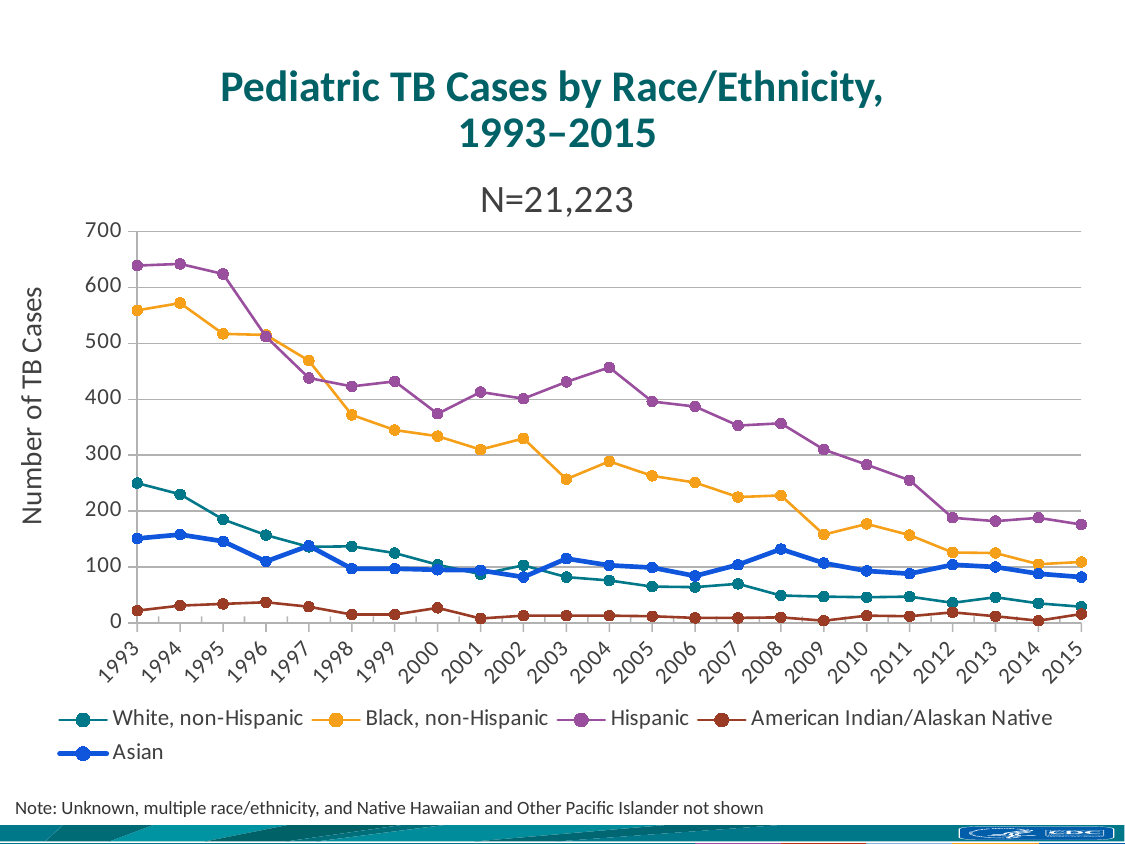
Which series has the lowest value in 2015? American Indian/Alaskan Native What kind of chart is shown on the slide? line chart In 2008, which is larger: Asian or White, non-Hispanic? Asian In 2004, which is larger: Hispanic or Black, non-Hispanic? Hispanic Which series has the highest value in 2015? Hispanic Is the value for Hispanic in 1993 greater or less than 600? greater Is the value for White, non-Hispanic in 1993 greater or less than 200? greater How many years are plotted along the x axis? 23 Do the values for Hispanic rise or fall from 1993 to 2015? fall How many series does the legend list? 5 What is the title of the chart? Pediatric TB Cases by Race/Ethnicity, 1993–2015 Is the value for Black, non-Hispanic in 2015 greater or less than 200? less